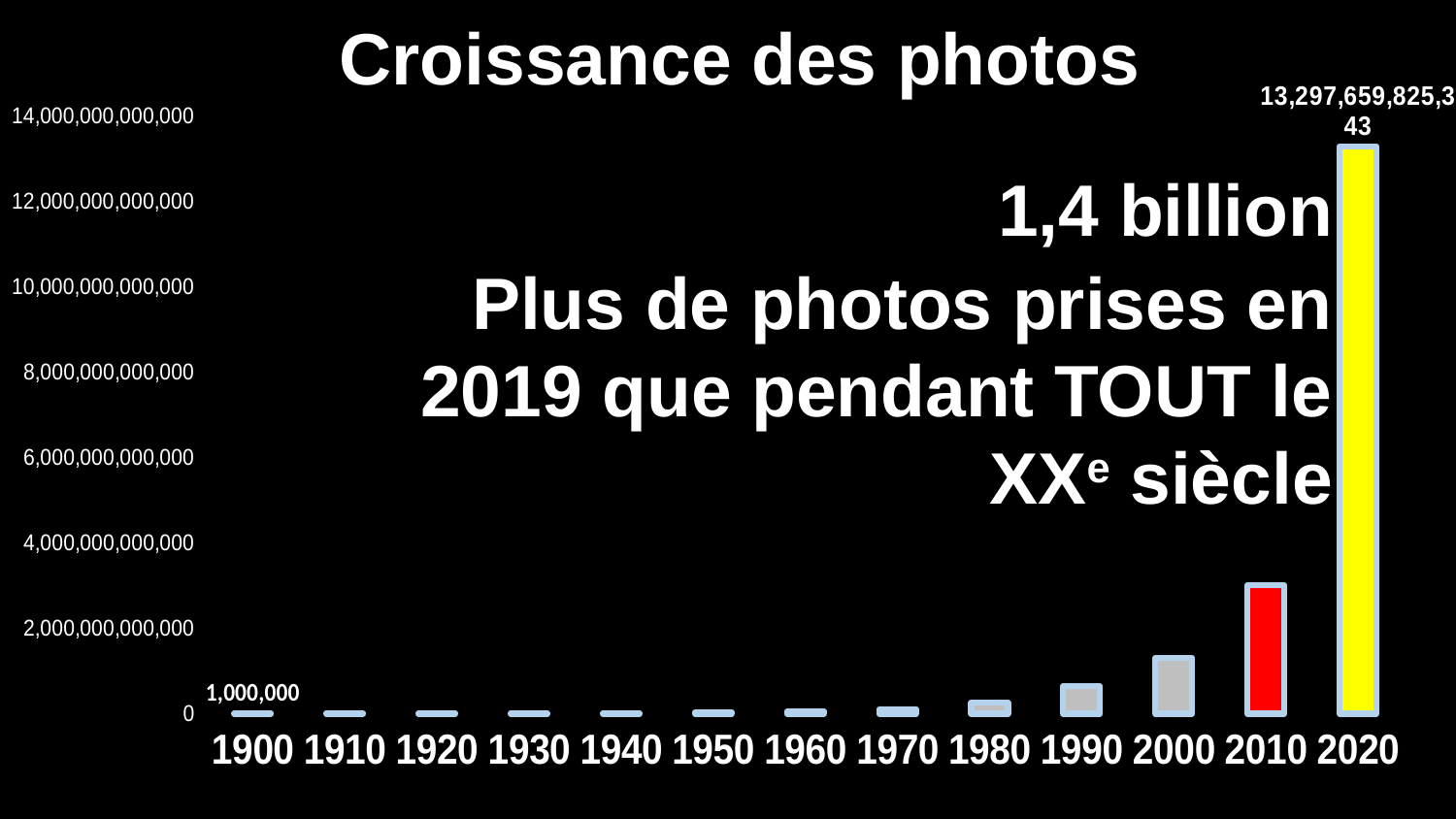
What value is labelled on the bar for 1900? 1,000,000 How many years (categories) are shown on the x axis of the chart? 13 Is the value for 2010 greater or less than 2,000,000,000,000? greater What is the title of the chart? Croissance des photos What kind of chart is shown on the slide? bar chart Is the value for 2010 greater or less than 4,000,000,000,000? less What colour is the bar for 2010? red Which year has the highest bar in the chart? 2020 What value is labelled on the bar for 2020? 13,297,659,825,343 Is the value for 2000 greater or less than 2,000,000,000,000? less Do the values generally rise or fall from 1900 to 2020? rise Which is larger, the value for 2010 or the value for 2000? 2010